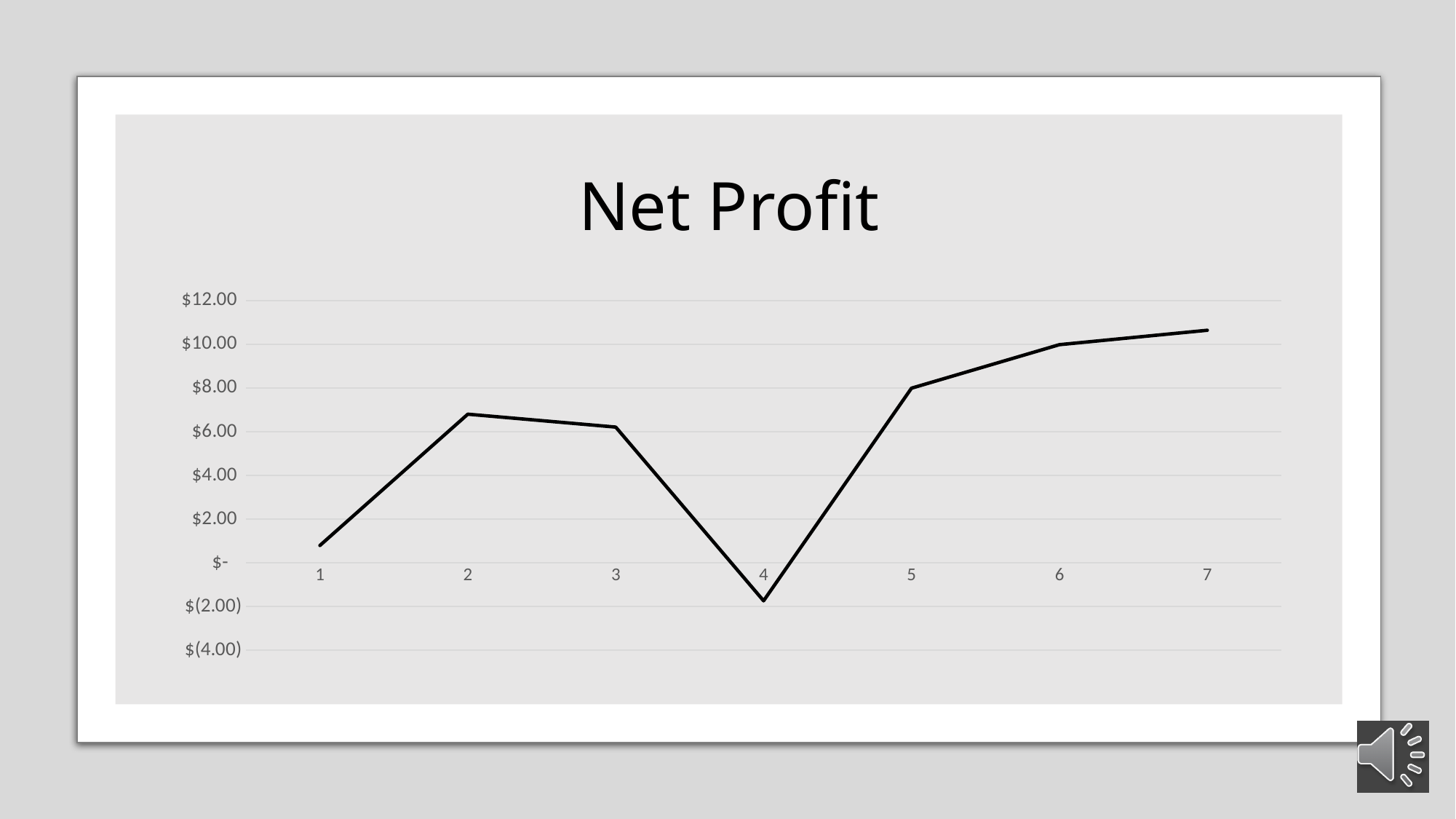
Is the net profit at point 1 greater or less than $2.00? less Is the net profit at point 4 greater or less than $-? less At which x-axis point is net profit lowest? 4 Which has the higher net profit, point 4 or point 1? 1 At which x-axis point is net profit highest? 7 Is the net profit at point 2 greater or less than $6.00? greater Does net profit rise or fall from point 4 to point 7? rise What is the title of the chart? Net Profit Which has the higher net profit, point 2 or point 5? 5 What kind of chart is shown on the slide? line chart How many points are plotted along the x axis? 7